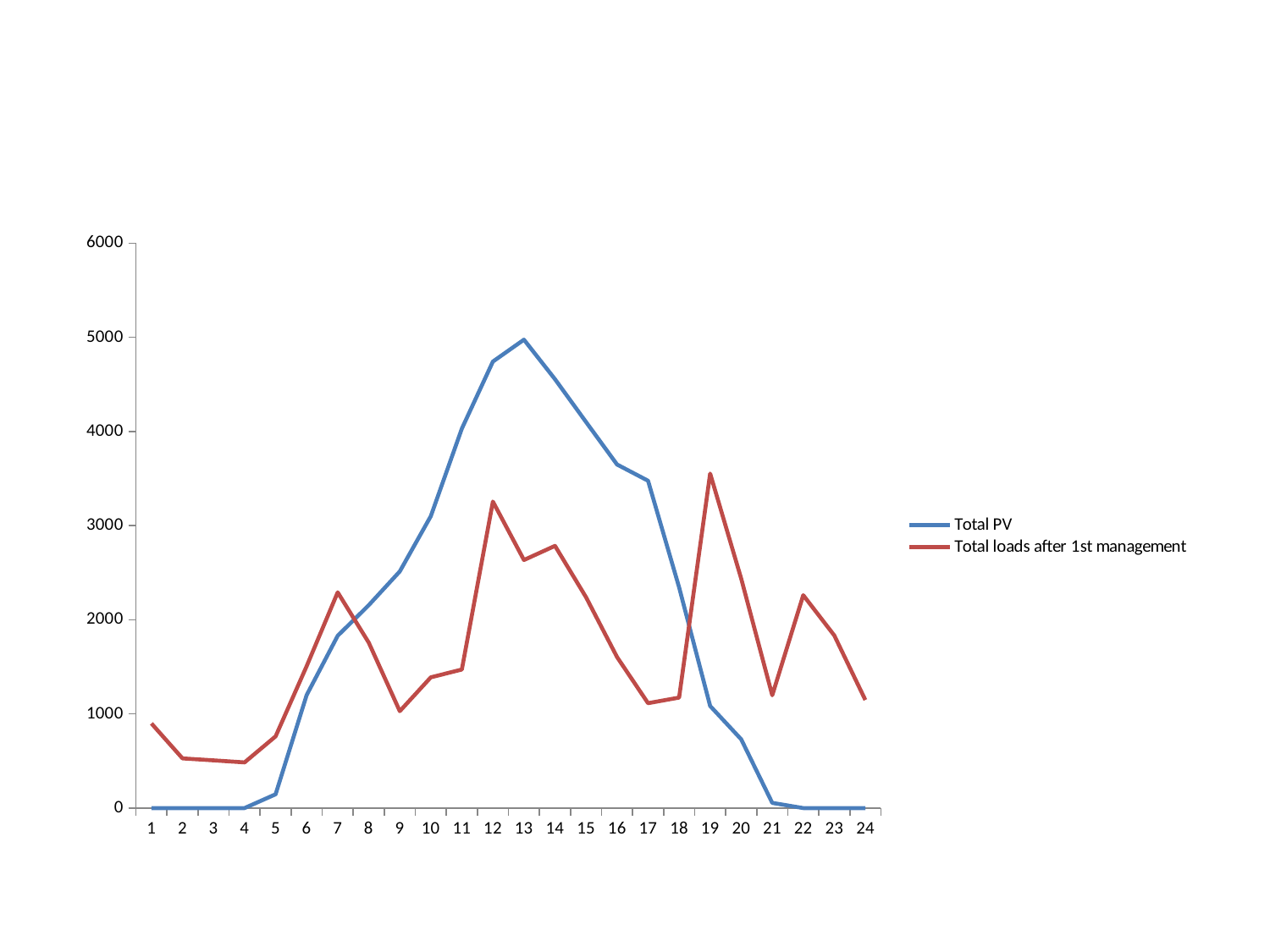
Does the Total PV series rise or fall between 13 and 21 on the x axis? Fall What kind of chart is shown on the slide? Line chart Is the value for Total PV at 13 greater or less than 4000? greater Is the value for Total loads after 1st management at 9 greater or less than 2000? less Which series has the higher value at 13, Total PV or Total loads after 1st management? Total PV What colour is the line for Total loads after 1st management? Red How many points are plotted along the x axis for each series? 24 At which x-axis value does the Total PV series reach its highest point? 13 At which x-axis value does the Total loads after 1st management series reach its highest point? 19 Which series has the higher value at 19, Total PV or Total loads after 1st management? Total loads after 1st management Is the value for Total loads after 1st management at 19 greater or less than 3000? greater How many series does the legend list? 2